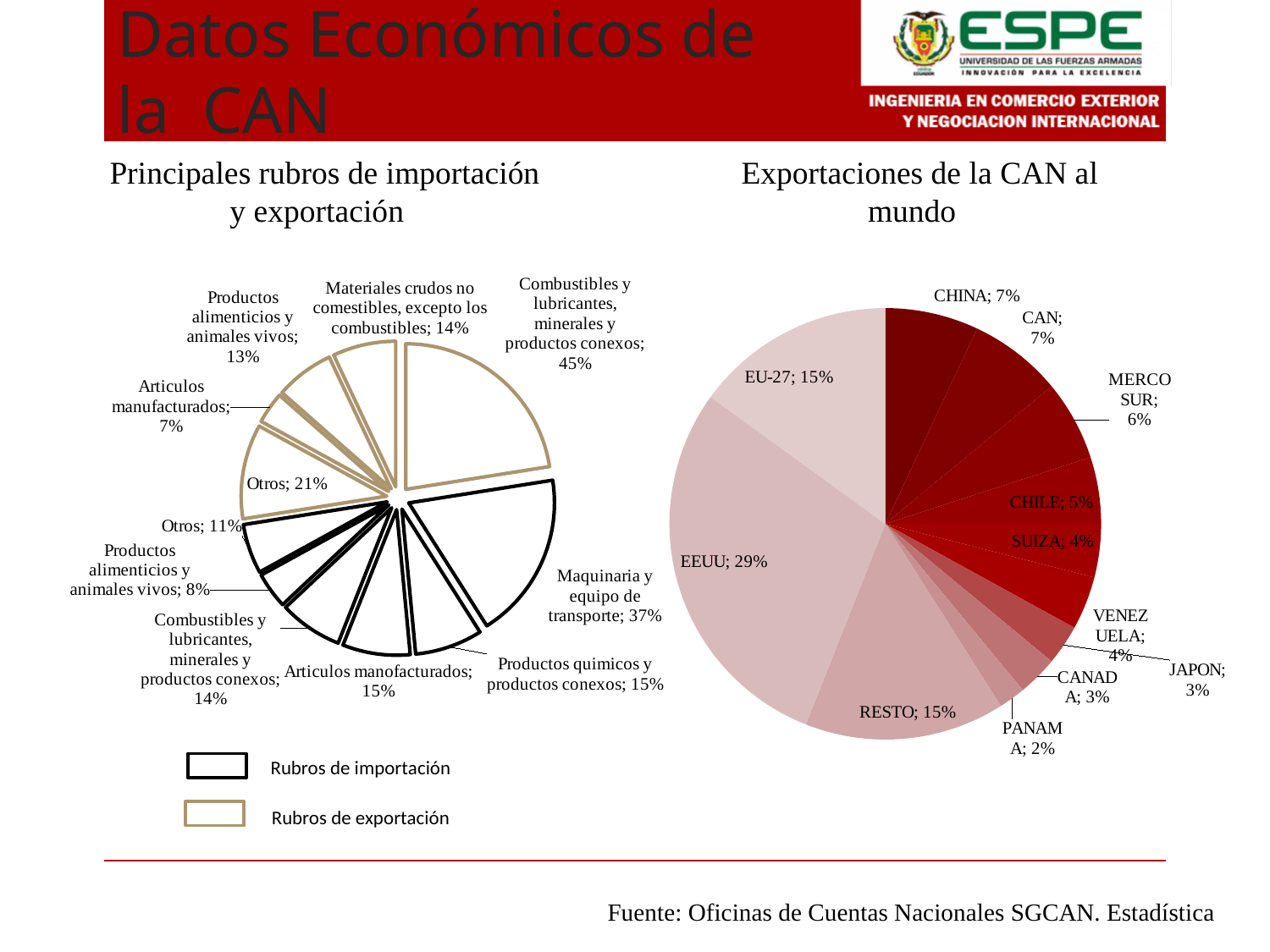
In the 'Exportaciones de la CAN al mundo' pie chart, which destination has the largest share? EEUU What kind of chart is 'Exportaciones de la CAN al mundo'? Pie chart In the 'Principales rubros de importación y exportación' pie chart, what is the share of 'Maquinaria y equipo de transporte'? 37% How many entries does the legend of the 'Principales rubros de importación y exportación' chart list? 2 In the 'Principales rubros de importación y exportación' pie chart, what is the share of 'Combustibles y lubricantes, minerales y productos conexos' among the export items (Rubros de exportación)? 45% How many slices does the 'Exportaciones de la CAN al mundo' pie chart have? 12 In the 'Principales rubros de importación y exportación' chart, which legend entry is drawn with a black outline? Rubros de importación In the 'Exportaciones de la CAN al mundo' pie chart, which destination has the smallest share? PANAMA In the 'Exportaciones de la CAN al mundo' pie chart, what share does EEUU have? 29% In the 'Exportaciones de la CAN al mundo' pie chart, what is the difference between the shares of EEUU and EU-27? 14% In the 'Exportaciones de la CAN al mundo' pie chart, which is larger, the share of MERCOSUR or the share of CHILE? MERCOSUR In the 'Principales rubros de importación y exportación' pie chart, what is the difference between the export share of 'Materiales crudos no comestibles, excepto los combustibles' (14%) and the export share of 'Articulos manufacturados' (7%)? 7%